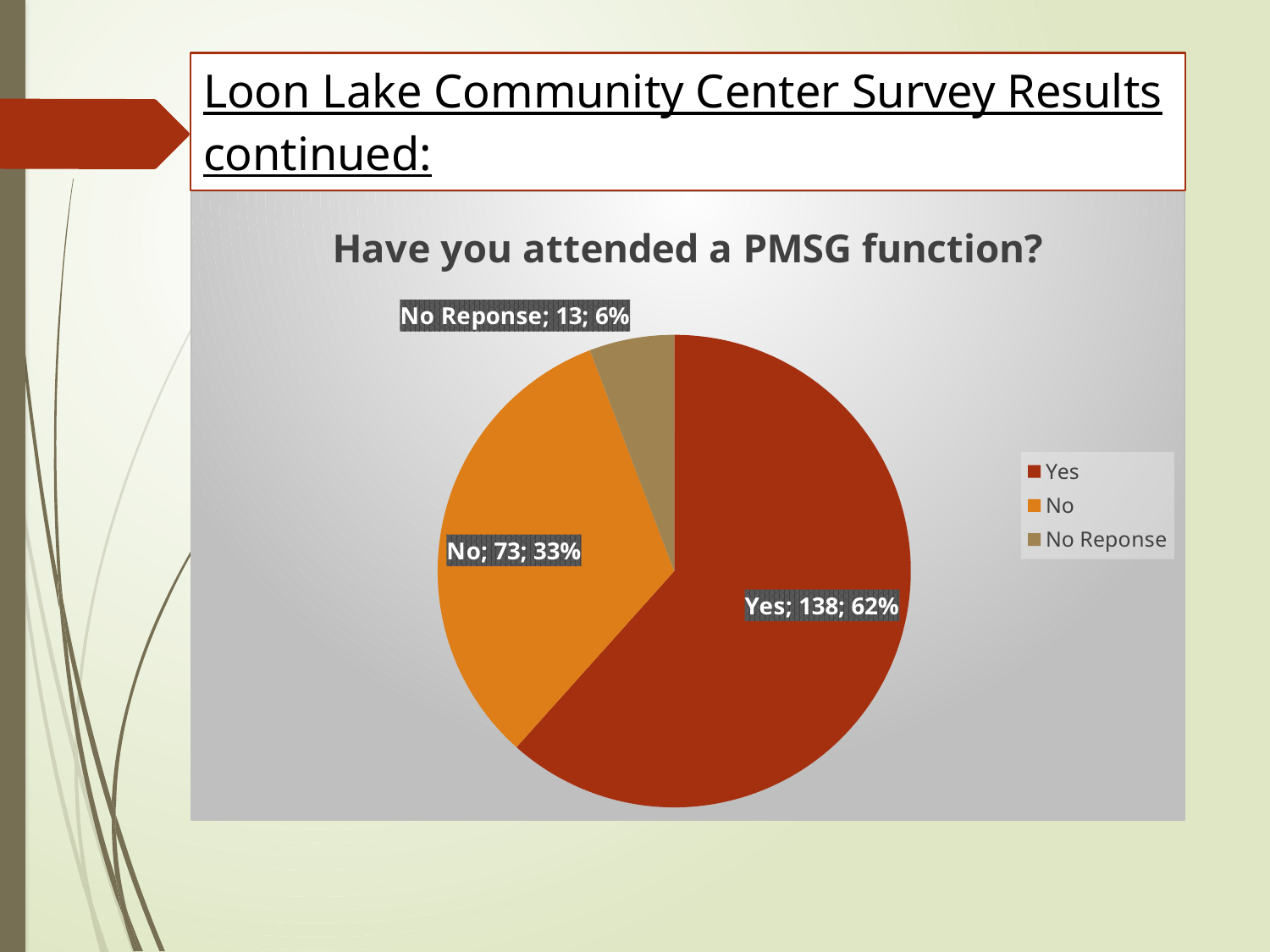
Which category has the largest slice? Yes What share of the pie does the No slice represent? 33% What is the title of the chart? Have you attended a PMSG function? How many categories does the legend list? 3 What is the difference between the number of Yes and No responses? 65 How many respondents answered No? 73 How many respondents gave No Reponse? 13 Which category has the smallest slice? No Reponse What kind of chart is shown on the slide? pie chart Which is larger, the No slice or the No Reponse slice? No What share of the pie does the Yes slice represent? 62% How many respondents answered Yes? 138